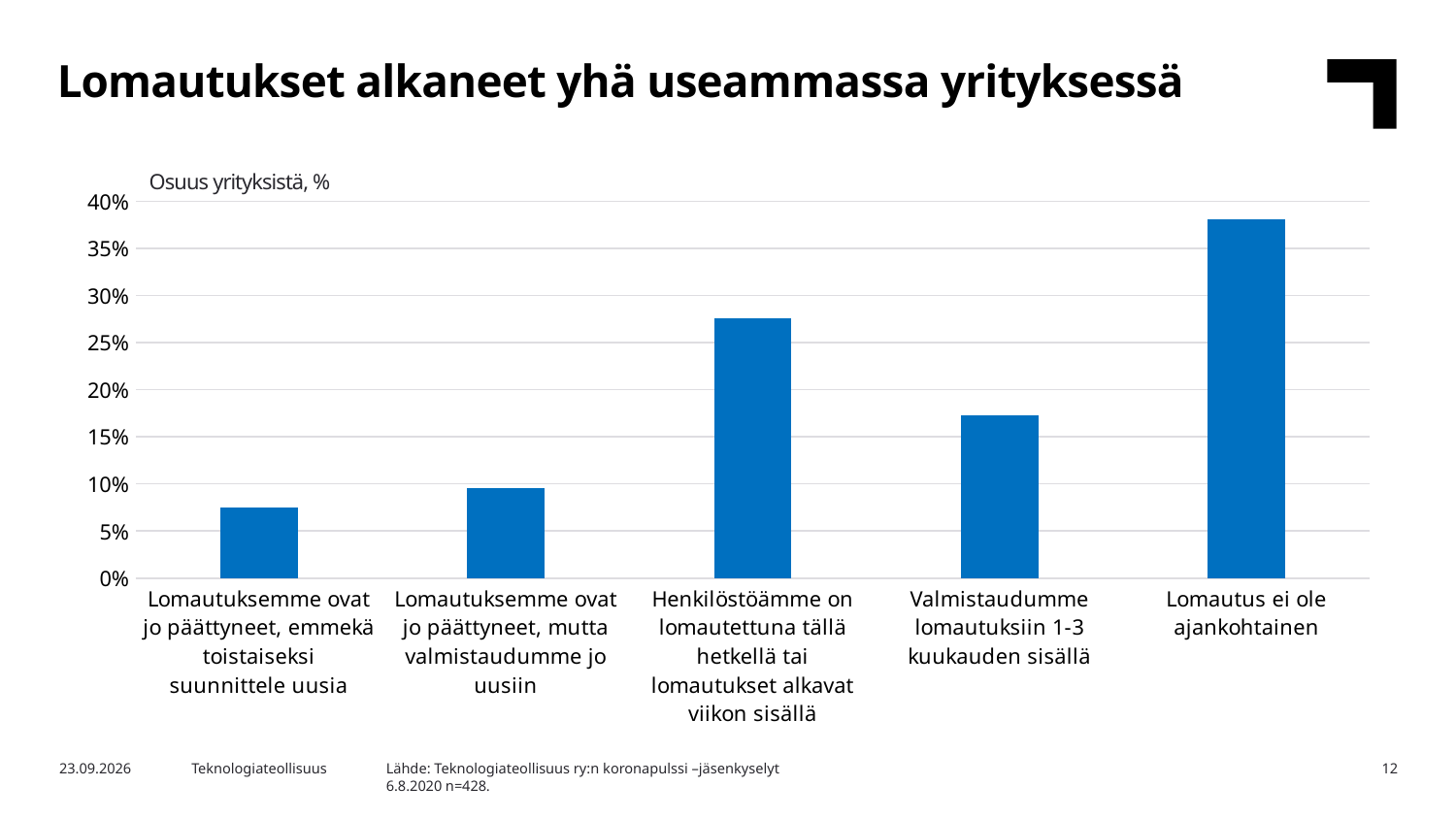
What kind of chart is shown on the slide? bar chart Which category has the lowest value? Lomautuksemme ovat jo päättyneet, emmekä toistaiseksi suunnittele uusia Is the value for 'Valmistaudumme lomautuksiin 1-3 kuukauden sisällä' greater or less than 20%? less What is the title of the slide? Lomautukset alkaneet yhä useammassa yrityksessä Which is larger: the value for 'Lomautuksemme ovat jo päättyneet, mutta valmistaudumme jo uusiin' or the value for 'Lomautus ei ole ajankohtainen'? Lomautus ei ole ajankohtainen Which category has the highest value? Lomautus ei ole ajankohtainen How many categories are shown on the x axis of the chart? 5 What label is shown above the y axis of the chart? Osuus yrityksistä, % Which is larger: the value for 'Henkilöstöämme on lomautettuna tällä hetkellä tai lomautukset alkavat viikon sisällä' or the value for 'Valmistaudumme lomautuksiin 1-3 kuukauden sisällä'? Henkilöstöämme on lomautettuna tällä hetkellä tai lomautukset alkavat viikon sisällä Is the value for 'Lomautus ei ole ajankohtainen' greater or less than 35%? greater Is the value for 'Henkilöstöämme on lomautettuna tällä hetkellä tai lomautukset alkavat viikon sisällä' greater or less than 25%? greater